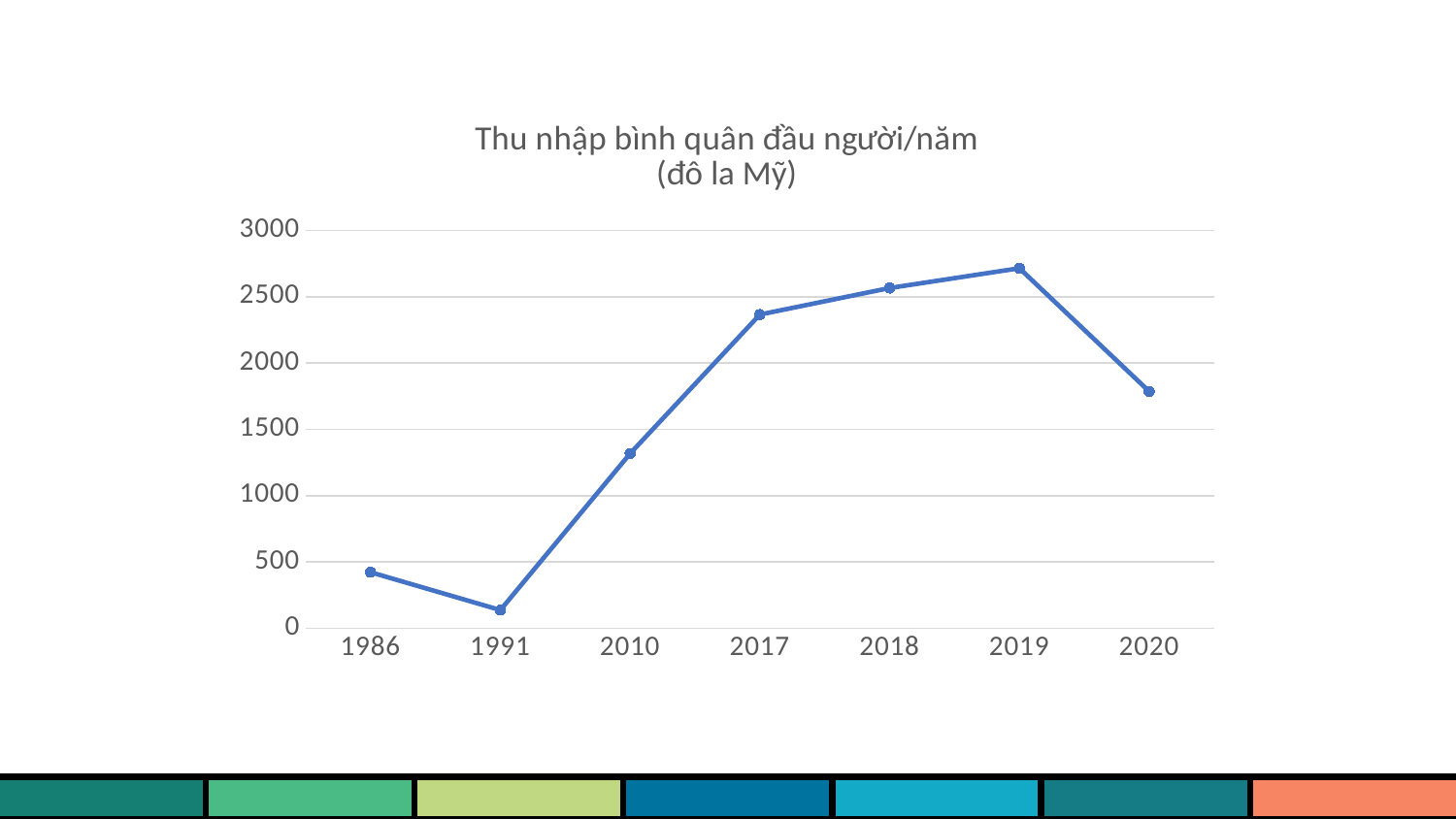
How many years are plotted on the x axis? 7 Is the value for 2020 greater or less than 2000? less Which year has the highest value? 2019 Is the value for 2019 greater or less than 2500? greater What kind of chart is shown on the slide? line chart Which year has the lowest value? 1991 Is the value for 1991 greater or less than 500? less Do the values rise or fall from 1991 to 2019? rise What is the title of the chart? Thu nhập bình quân đầu người/năm (đô la Mỹ) Which year has the larger value, 2017 or 2020? 2017